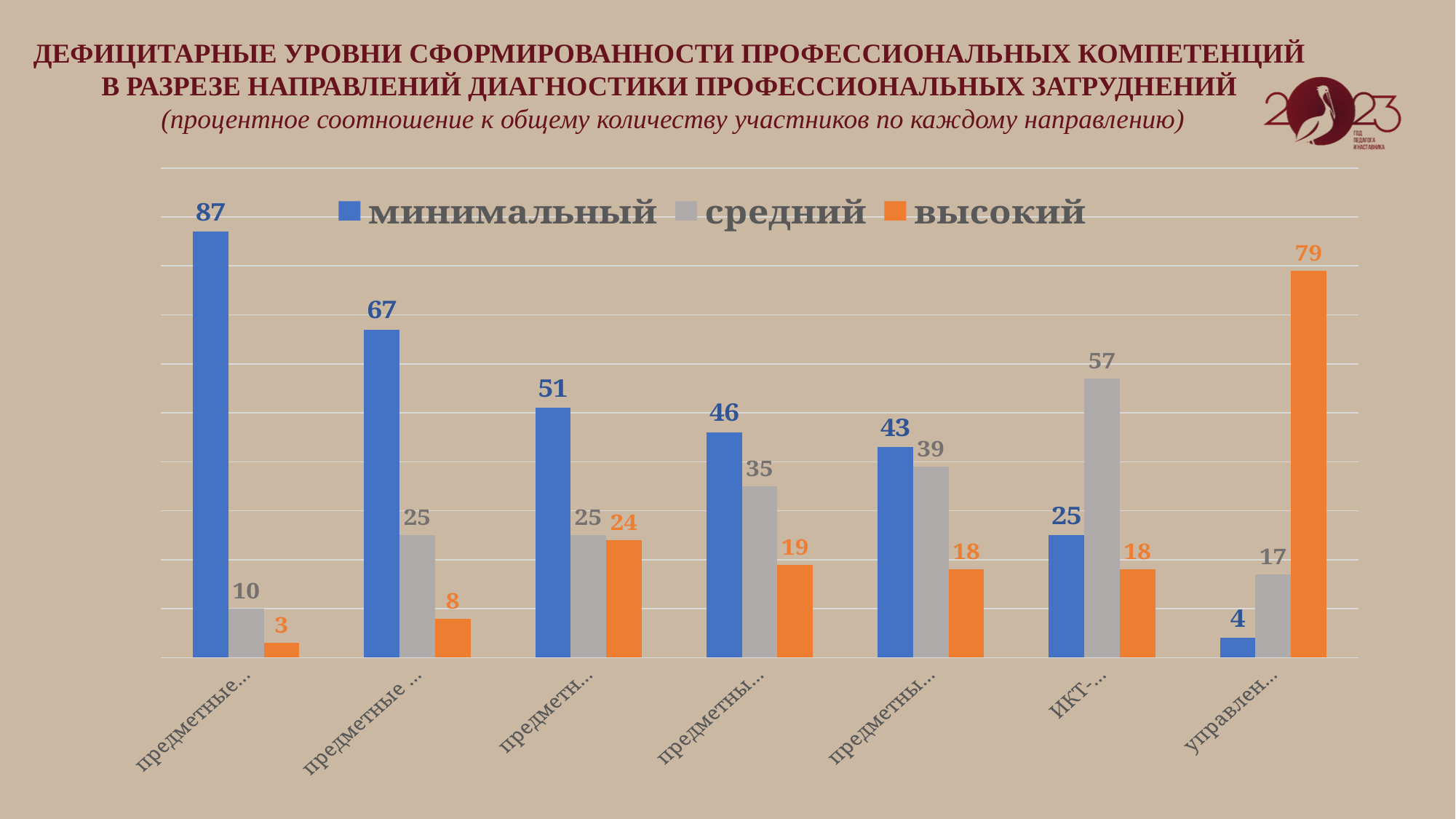
How many series does the legend list? 3 Which category has the highest value in the 'средний' series? ИКТ-... What is the value of the 'средний' series for the category labelled 'управлен...'? 17 What is the value of the 'минимальный' series for the first (leftmost) category? 87 What is the difference between the 'минимальный' and 'средний' values for the category labelled 'ИКТ-...'? 32 What is the value of the 'высокий' series for the category labelled 'ИКТ-...'? 18 Which category has the lowest value in the 'минимальный' series? управлен... Do the values of the 'минимальный' series rise or fall from left to right across the categories? fall How many categories are shown on the x axis? 7 What kind of chart is shown on the slide? bar chart Which category has the highest value in the 'высокий' series? управлен... For the third category from the left, which is larger: the 'средний' value or the 'высокий' value? средний